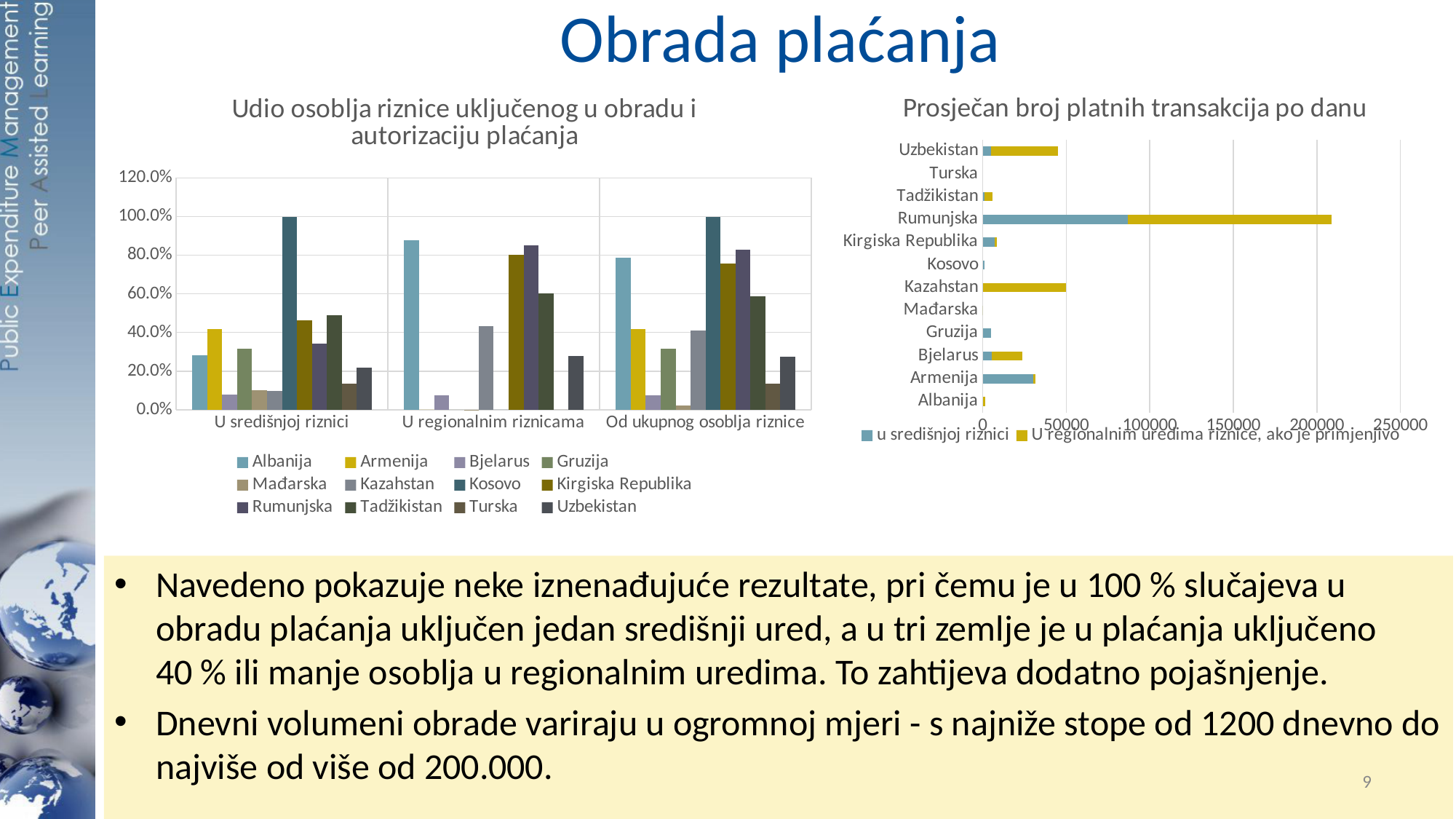
In the chart "Prosječan broj platnih transakcija po danu", how many series does the legend list? 2 In the chart "Udio osoblja riznice uključenog u obradu i autorizaciju plaćanja", how many categories are shown on the x axis? 3 In the chart "Udio osoblja riznice uključenog u obradu i autorizaciju plaćanja", which country has the highest bar in the "U središnjoj riznici" category? Kosovo What kind of chart is the chart titled "Udio osoblja riznice uključenog u obradu i autorizaciju plaćanja"? Bar chart In the chart "Udio osoblja riznice uključenog u obradu i autorizaciju plaćanja", in the "U središnjoj riznici" category, which is larger: Armenija or Bjelarus? Armenija What kind of chart is the chart titled "Prosječan broj platnih transakcija po danu"? Stacked horizontal bar chart In the chart "Udio osoblja riznice uključenog u obradu i autorizaciju plaćanja", is the value for Albanija in the "U regionalnim riznicama" category greater or less than 80.0%? greater In the chart "Prosječan broj platnih transakcija po danu", which country has the longest bar? Rumunjska In the chart "Udio osoblja riznice uključenog u obradu i autorizaciju plaćanja", how many series does the legend list? 12 In the chart "Prosječan broj platnih transakcija po danu", is the total bar for Rumunjska greater or less than 200000? greater In the chart "Prosječan broj platnih transakcija po danu", is the total bar for Uzbekistan greater or less than 50000? less In the chart "Prosječan broj platnih transakcija po danu", how many countries are listed on the vertical axis? 12